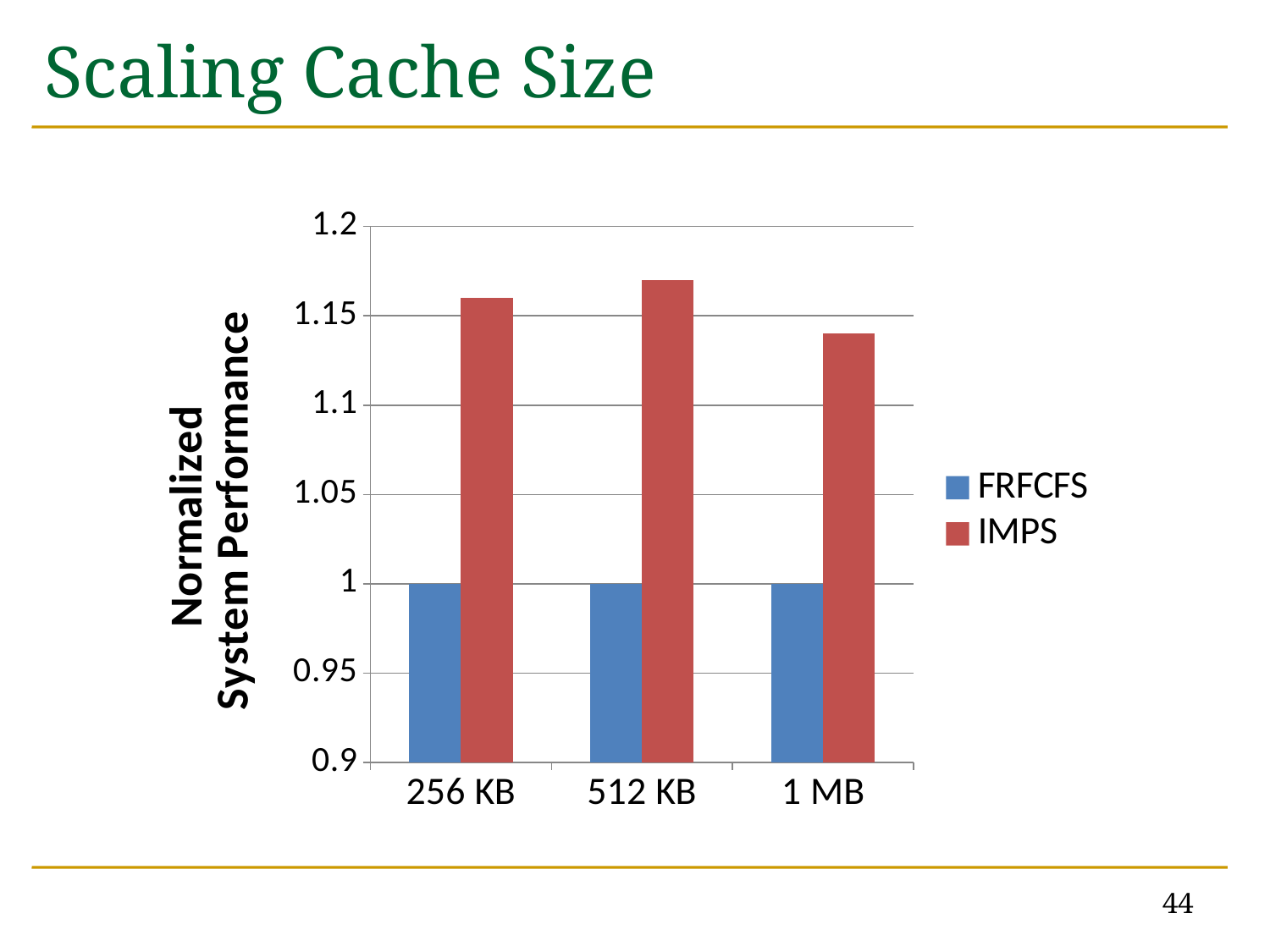
Is the value for IMPS at 512 KB greater or less than 1.1? greater Is the value for IMPS at 256 KB greater or less than 1.15? greater What kind of chart is shown on the slide? bar chart What is the label of the y axis? Normalized System Performance What is the normalized system performance of FRFCFS at 256 KB? 1 What is the normalized system performance of FRFCFS at 1 MB? 1 How many cache size categories are shown on the x axis? 3 Which is larger for IMPS, the value at 512 KB or the value at 1 MB? 512 KB At which cache size is the IMPS value lowest? 1 MB Which is larger at 512 KB, FRFCFS or IMPS? IMPS Is the value for IMPS at 1 MB greater or less than 1.15? less How many series does the legend list? 2